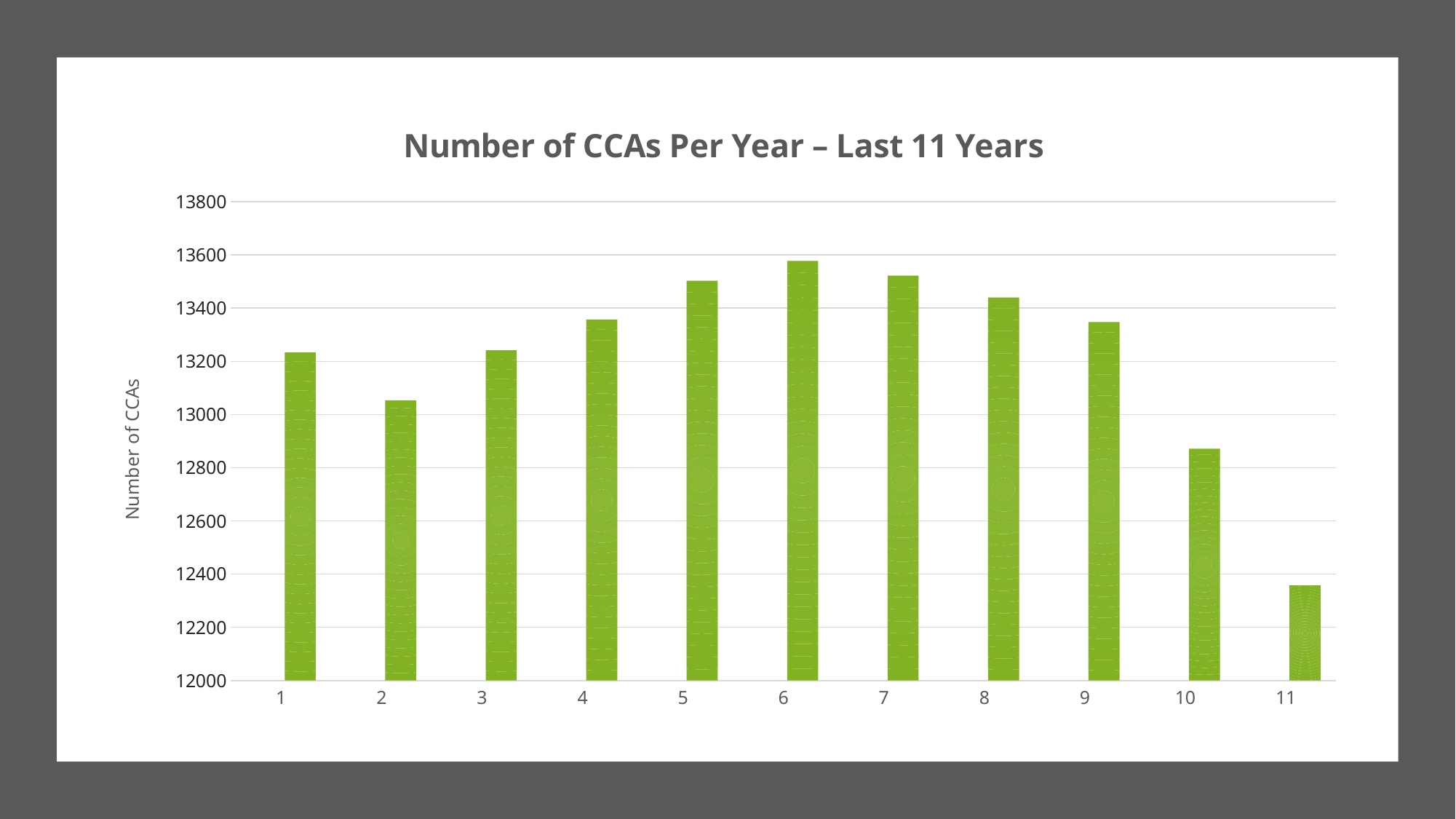
Which year has the highest number of CCAs? 6 What is the label on the vertical axis? Number of CCAs Is the value for year 10 greater or less than 13000? less What kind of chart is shown on the slide? Bar chart Which has more CCAs, year 2 or year 10? Year 2 Do the values rise or fall from year 6 to year 11? Fall What is the title of the chart? Number of CCAs Per Year – Last 11 Years Is the value for year 4 greater or less than 13400? less Is the value for year 6 greater or less than 13400? greater Which year has the lowest number of CCAs? 11 How many years (bars) are plotted in the chart? 11